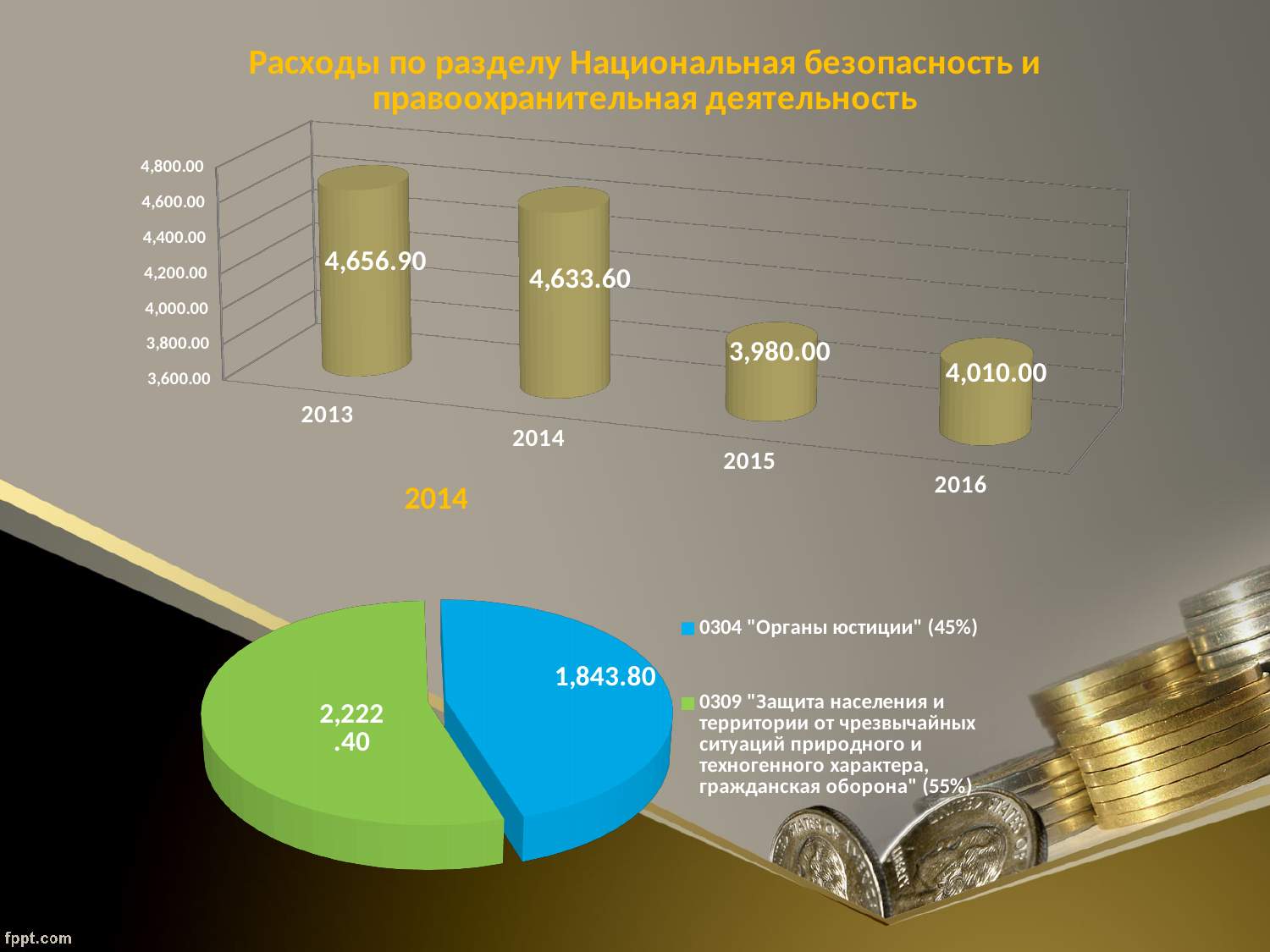
In the top bar chart, which year has the lowest value? 2015 In the top bar chart, what is the value for 2013? 4,656.90 In the pie chart titled 2014, how many entries does the legend list? 2 In the pie chart titled 2014, what share does the 0309 "Защита населения..." slice have? 55% In the pie chart titled 2014, what is the value for 0304 "Органы юстиции"? 1,843.80 In the top bar chart, which is larger, the value for 2015 or the value for 2016? 2016 In the top bar chart, what is the value for 2015? 3,980.00 In the top bar chart, do the values generally rise or fall from 2013 to 2016? fall In the top bar chart, how many years are shown? 4 What kind of chart is the top chart on the slide? bar chart In the top bar chart, what is the difference between the values for 2013 and 2014? 23.30 In the top bar chart, which year has the highest value? 2013